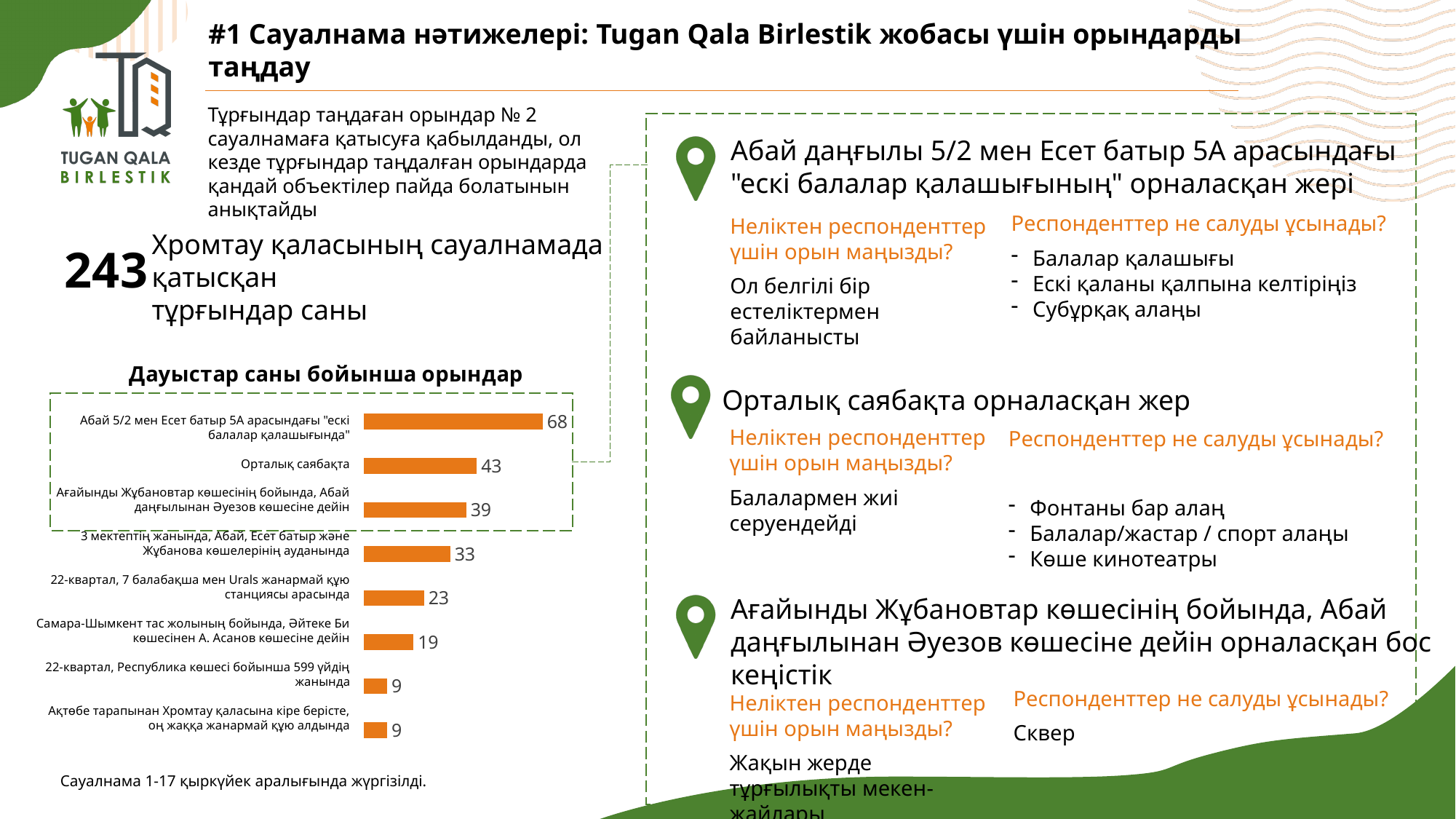
What is the value for "Самара-Шымкент тас жолының бойында, Әйтеке Би көшесінен А. Асанов көшесіне дейін" in the chart? 19 What is the value for "22-квартал, 7 балабақша мен Urals жанармай құю станциясы арасында" in the chart? 23 What type of chart is shown under the title "Дауыстар саны бойынша орындар"? bar chart What is the difference between the values for "Абай 5/2 мен Есет батыр 5А арасындағы "ескі балалар қалашығында"" and "Орталық саябақта"? 25 What is the difference between the values for "22-квартал, 7 балабақша мен Urals жанармай құю станциясы арасында" and "22-квартал, Республика көшесі бойынша 599 үйдің жанында"? 14 Which category has the highest value in the chart "Дауыстар саны бойынша орындар"? Абай 5/2 мен Есет батыр 5А арасындағы "ескі балалар қалашығында" What is the value for "Орталық саябақта" in the chart? 43 Which has a larger value: "Ағайынды Жұбановтар көшесінің бойында, Абай даңғылынан Әуезов көшесіне дейін" or "3 мектептің жанында, Абай, Есет батыр және Жұбанова көшелерінің ауданында"? Ағайынды Жұбановтар көшесінің бойында, Абай даңғылынан Әуезов көшесіне дейін What is the value for "Абай 5/2 мен Есет батыр 5А арасындағы "ескі балалар қалашығында"" in the chart? 68 What is the lowest value shown in the chart "Дауыстар саны бойынша орындар"? 9 How many categories (locations) are shown in the chart "Дауыстар саны бойынша орындар"? 8 What is the title of the bar chart on the slide? Дауыстар саны бойынша орындар